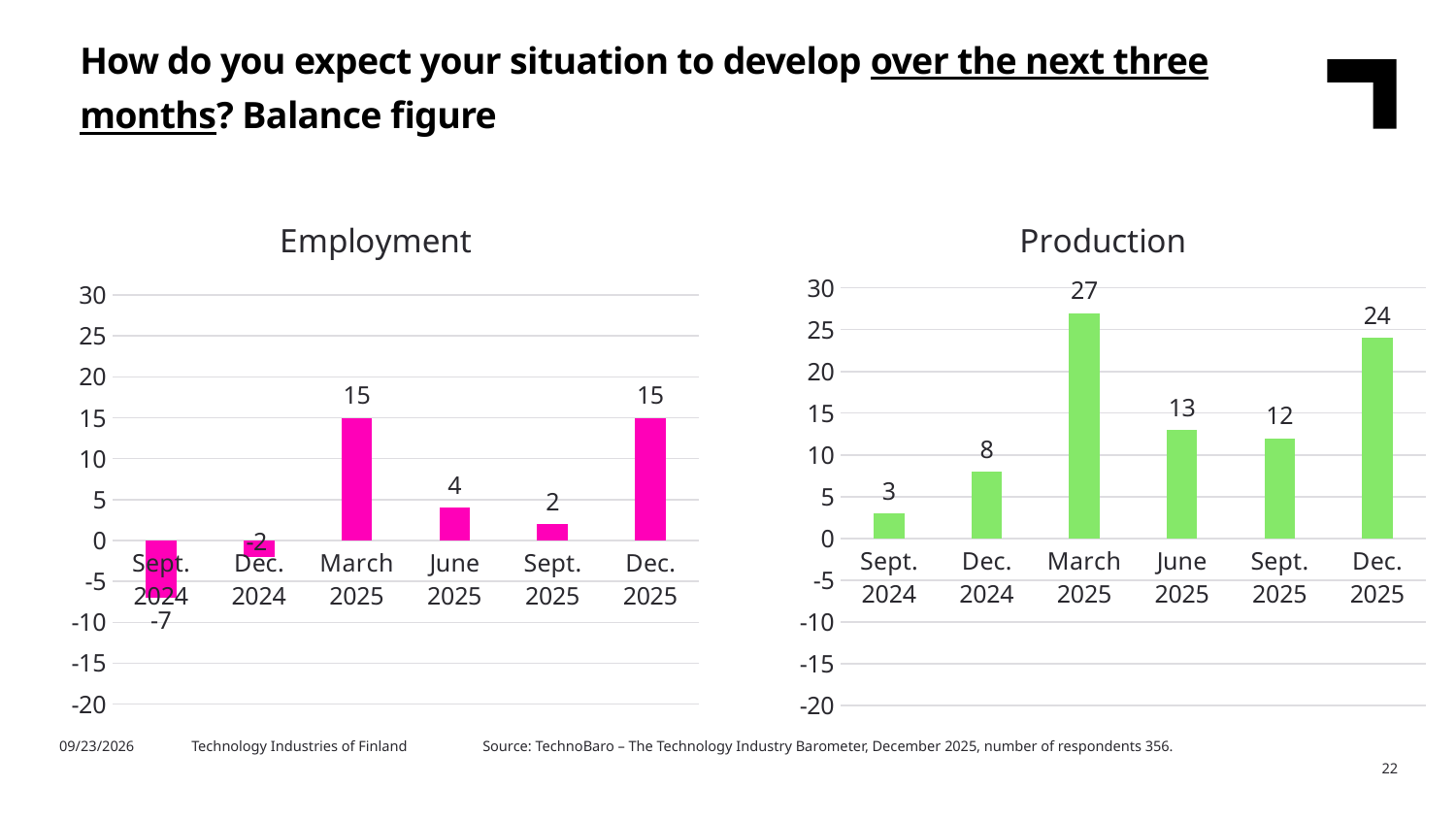
What type of chart is the Production chart? Bar chart In the Employment chart, what is the value for March 2025? 15 In the Production chart, what is the value for Dec. 2024? 8 In the Production chart, what is the difference between the values for March 2025 and June 2025? 14 In the Production chart, which is larger, the value for June 2025 or Sept. 2025? June 2025 In the Production chart, which period has the lowest value? Sept. 2024 In the Production chart, what is the value for Dec. 2025? 24 In the Employment chart, which period has the lowest value? Sept. 2024 In the Production chart, which period has the highest value? March 2025 In the Employment chart, what is the difference between the values for June 2025 and Sept. 2025? 2 In the Employment chart, what is the value for Sept. 2024? -7 How many periods are shown on the x axis of the Employment chart? 6